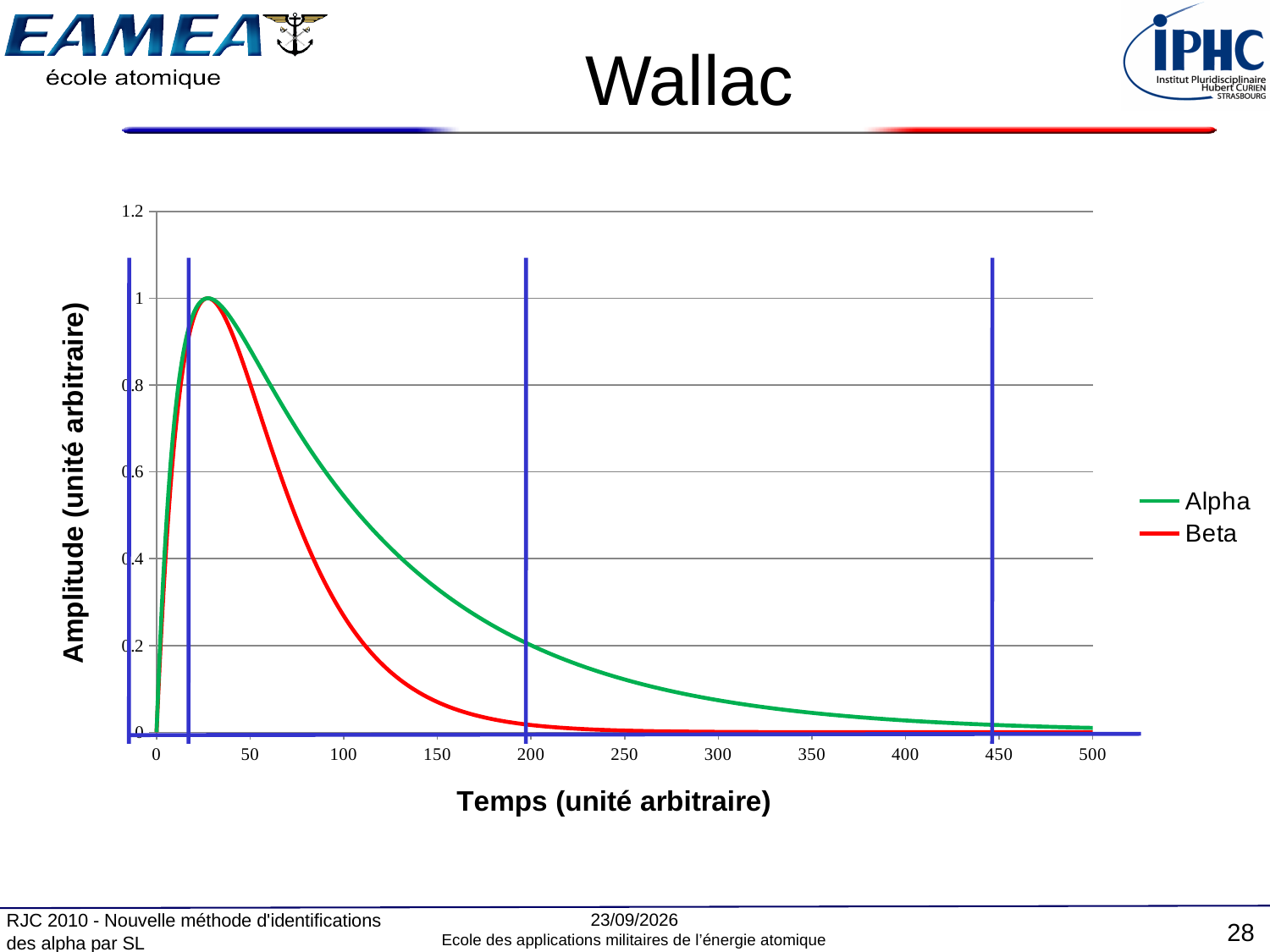
Is the amplitude of the Beta curve at time 100 greater or less than 0.4? less Is the amplitude of the Alpha curve at time 150 greater or less than 0.2? greater Is the amplitude of the Alpha curve at time 300 greater or less than 0.2? less What kind of chart is shown on the slide? line chart How many series does the legend list? 2 What is the maximum amplitude reached by the Alpha curve? 1 What is the title of the x axis? Temps (unité arbitraire) What are the names of the two series in the legend? Alpha and Beta Which series decays to near zero faster, Alpha or Beta? Beta After reaching their peak, do the Alpha and Beta curves rise or fall as time increases? fall At time 100, which series has the higher amplitude, Alpha or Beta? Alpha